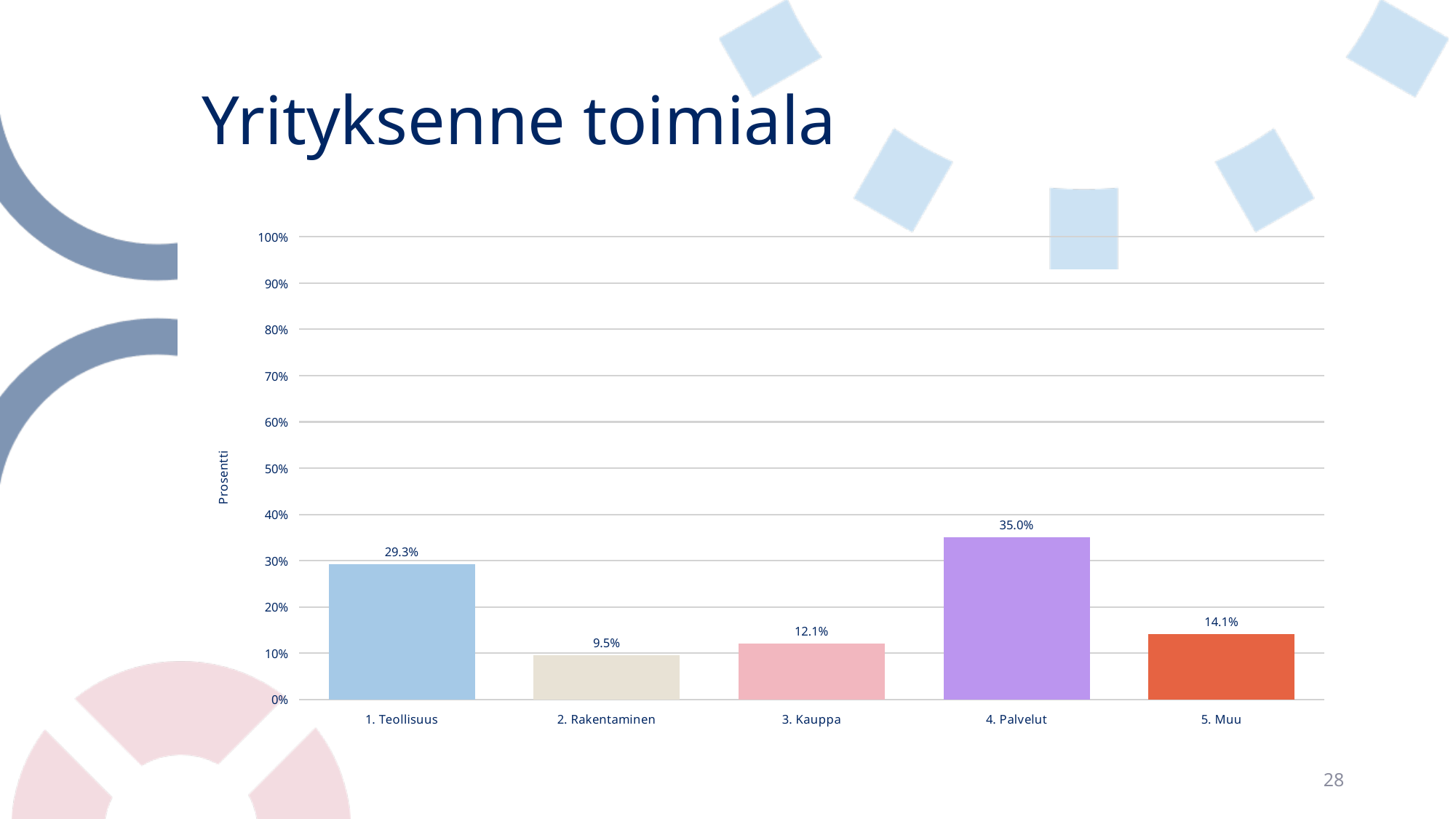
Is the value for 1. Teollisuus greater or less than 20%? greater Which is larger, the value for 3. Kauppa or the value for 5. Muu? 5. Muu What is the value for 5. Muu? 14.1% Which category has the highest value? 4. Palvelut What is the difference between the values for 4. Palvelut and 1. Teollisuus? 5.7% What is the value for 2. Rakentaminen? 9.5% What kind of chart is shown on the slide? bar chart What is the value for 4. Palvelut? 35.0% Which category has the lowest value? 2. Rakentaminen What is the value for 1. Teollisuus? 29.3% What is the label of the vertical axis? Prosentti How many categories are shown on the x axis? 5